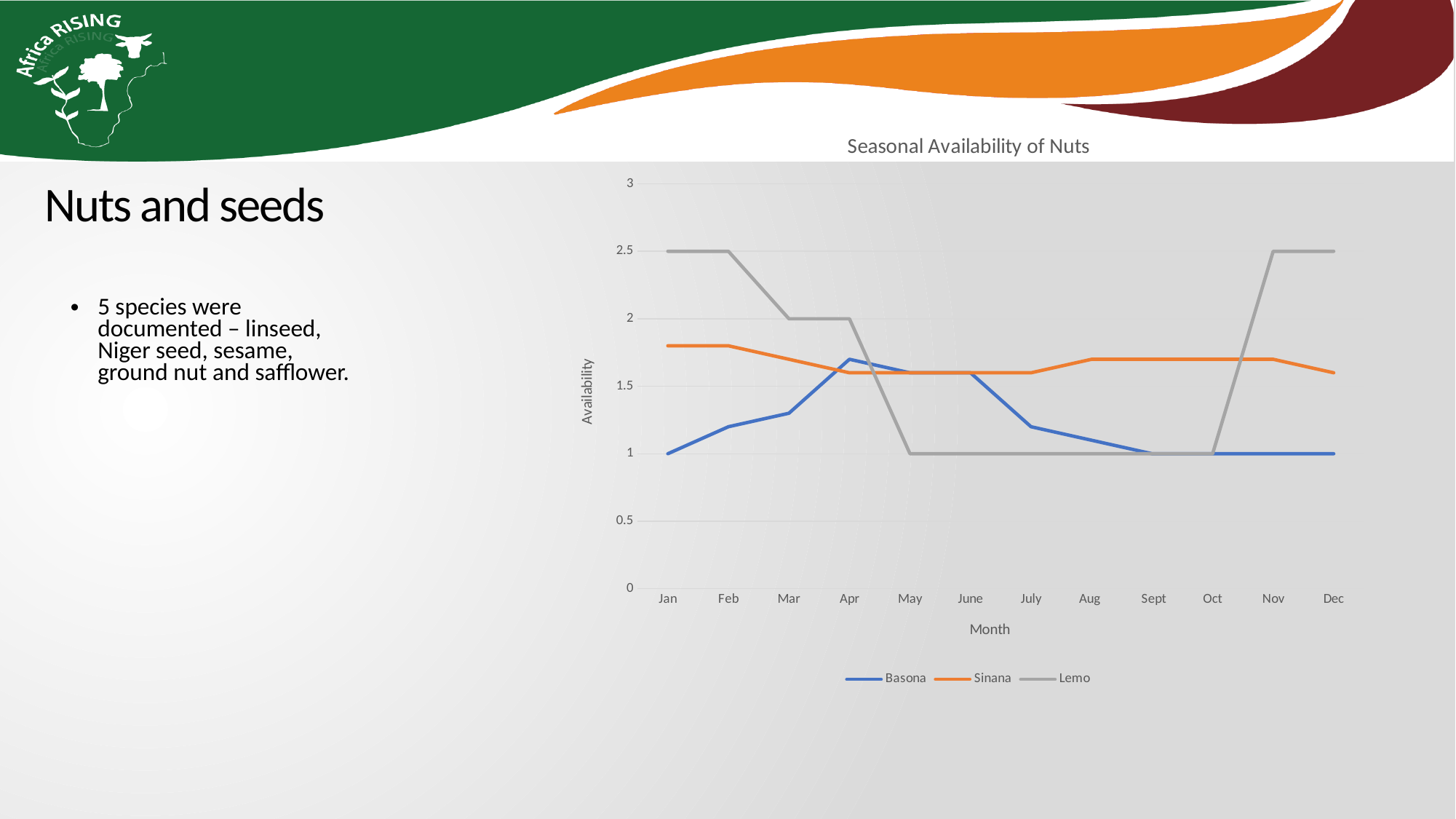
What kind of chart is shown on the slide? line chart How many months are plotted along the x axis? 12 Which series has the highest availability in Jan? Lemo Does the Lemo line rise or fall from Feb to May? fall What is the availability value for Lemo in Jan? 2.5 Which series has the lowest availability in Jan? Basona What is the availability value for Basona in Jan? 1 What is the availability value for Lemo in May? 1 In Jan, which is larger: the value for Lemo or the value for Sinana? Lemo How many series does the chart legend list? 3 What is the title of the chart? Seasonal Availability of Nuts Is the value for Sinana in Jan greater or less than 1.5? greater